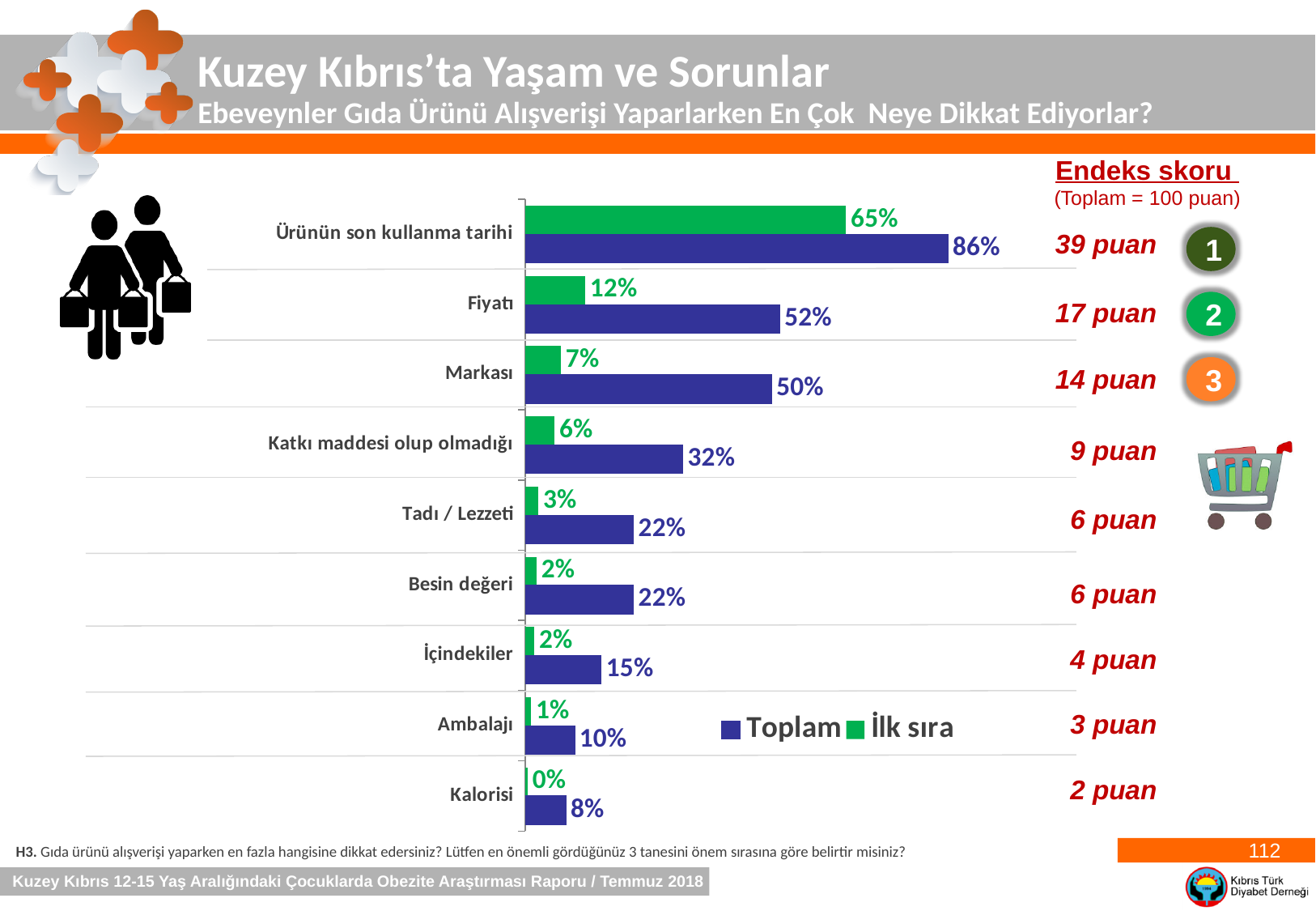
What is the difference between the Toplam values for Ürünün son kullanma tarihi and Fiyatı? 34% Which category has the lowest İlk sıra value? Kalorisi How many categories are shown in the chart? 9 What kind of chart is shown on the slide? Bar chart What is the İlk sıra value for Fiyatı? 12% What is the Toplam value for Ürünün son kullanma tarihi? 86% Which series is shown in green in the legend? İlk sıra What is the difference between the Toplam and İlk sıra values for Markası? 43% How many series does the legend list? 2 Which category has the highest Toplam value? Ürünün son kullanma tarihi Which is larger, the Toplam value for Fiyatı or the Toplam value for Markası? Fiyatı What is the Toplam value for Katkı maddesi olup olmadığı? 32%